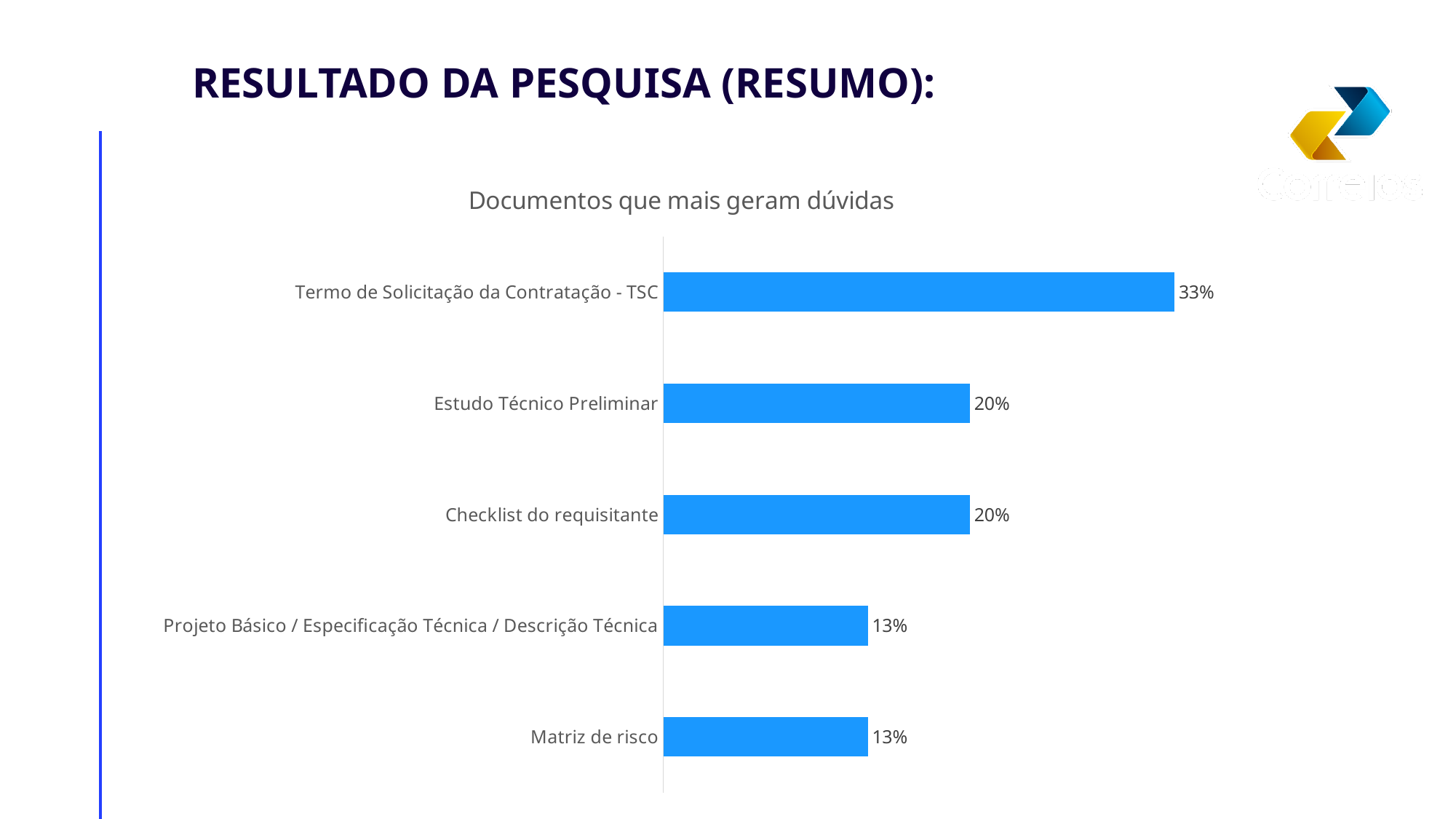
What colour are the bars in the chart? Blue How many categories are shown in the chart? 5 What is the value for Matriz de risco? 13% What is the value for Termo de Solicitação da Contratação - TSC? 33% Which is larger, the value for Checklist do requisitante or the value for Matriz de risco? Checklist do requisitante Which document has the highest value? Termo de Solicitação da Contratação - TSC What is the value for Estudo Técnico Preliminar? 20% What is the title of the chart? Documentos que mais geram dúvidas What is the difference between the values for Termo de Solicitação da Contratação - TSC and Estudo Técnico Preliminar? 13% What is the value for Projeto Básico / Especificação Técnica / Descrição Técnica? 13% What is the difference between the values for Checklist do requisitante and Matriz de risco? 7% What kind of chart is shown on the slide? Bar chart